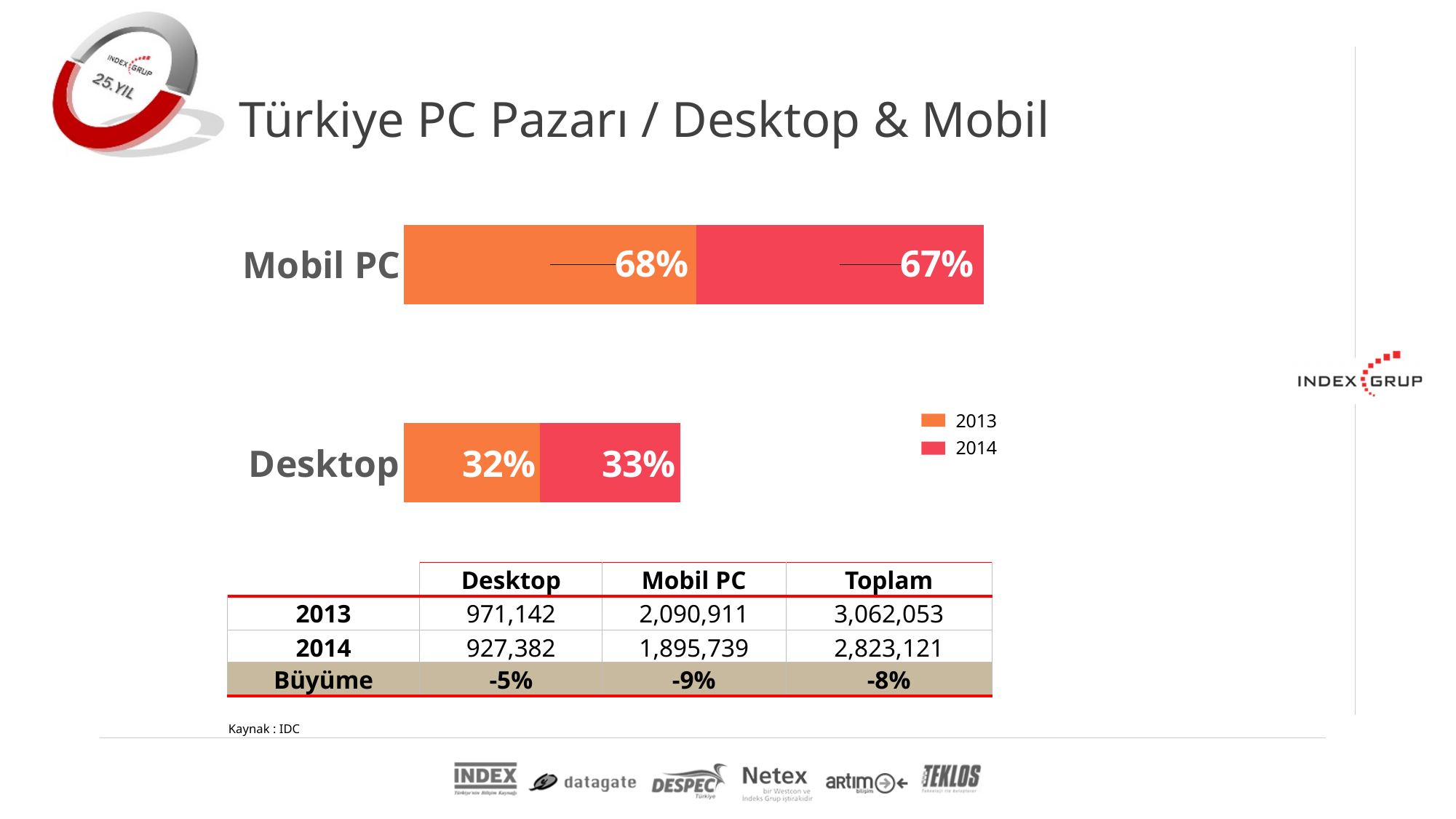
What is the 2014 value for Desktop in the bar chart? 33% How many series does the legend of the bar chart list? 2 How many categories are shown in the bar chart? 2 What is the difference between the Mobil PC and Desktop values for 2013 in the bar chart? 36% What is the difference between the 2013 and 2014 values for Desktop in the bar chart? 1% What is the total of the stacked bar for Mobil PC? 135% What is the 2014 value for Mobil PC in the bar chart? 67% Which category has the higher 2013 value in the bar chart, Mobil PC or Desktop? Mobil PC What is the 2013 value for Mobil PC in the bar chart? 68% Which category has the lowest 2014 value in the bar chart? Desktop What type of chart is shown on the slide? Stacked bar chart What is the 2013 value for Desktop in the bar chart? 32%